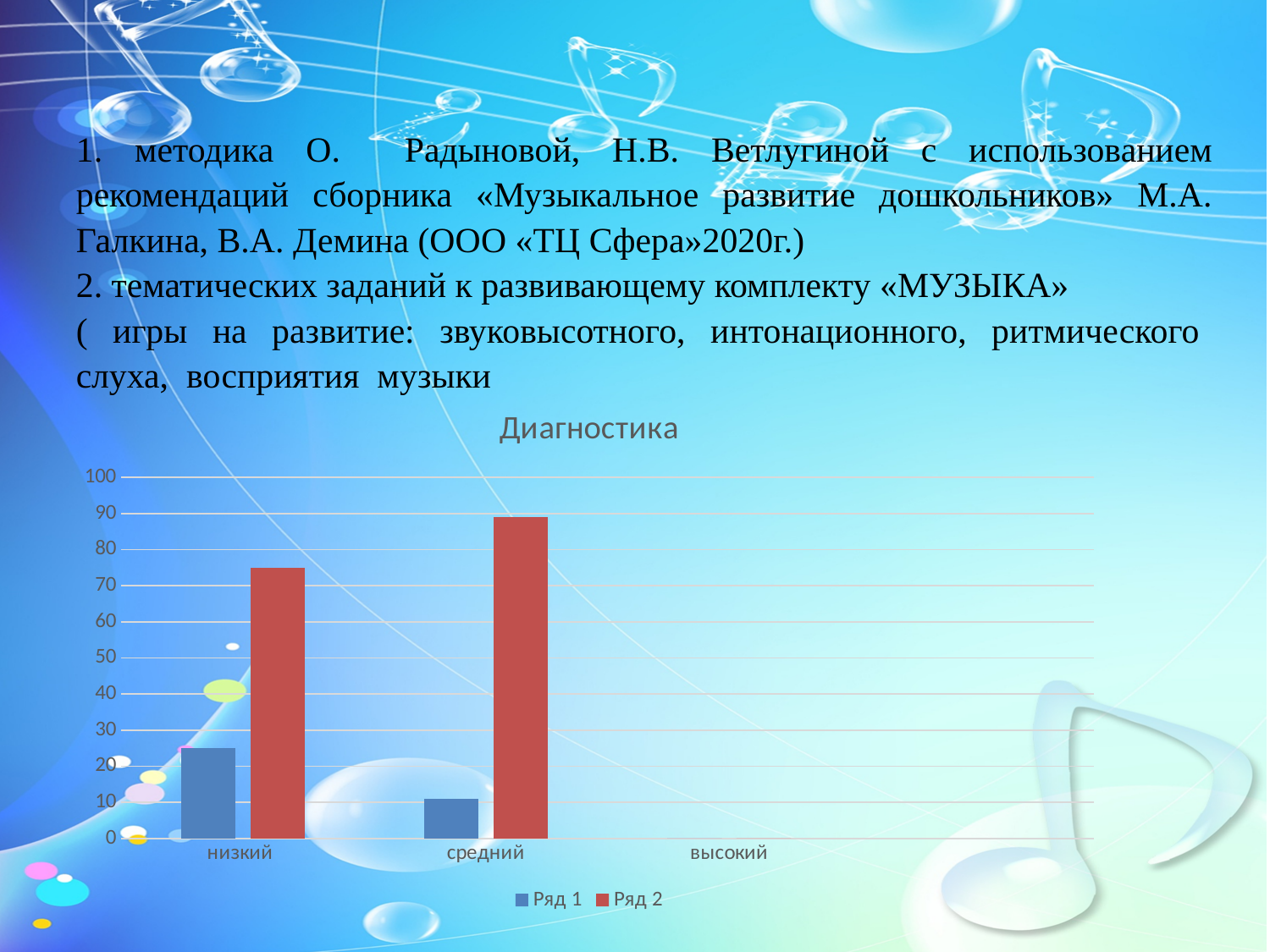
Is the value of Ряд 2 for средний greater or less than 80? greater For Ряд 1, which is larger: низкий or средний? низкий Is the value of Ряд 2 for низкий greater or less than 60? greater What kind of chart is shown on the slide? bar chart Which series is shown in red? Ряд 2 What is the title of the chart? Диагностика How many categories are shown on the x axis? 3 For Ряд 2, which category has the highest value? средний Is the value of Ряд 1 for низкий greater or less than 30? less For the category низкий, which series has the larger value? Ряд 2 How many series does the legend list? 2